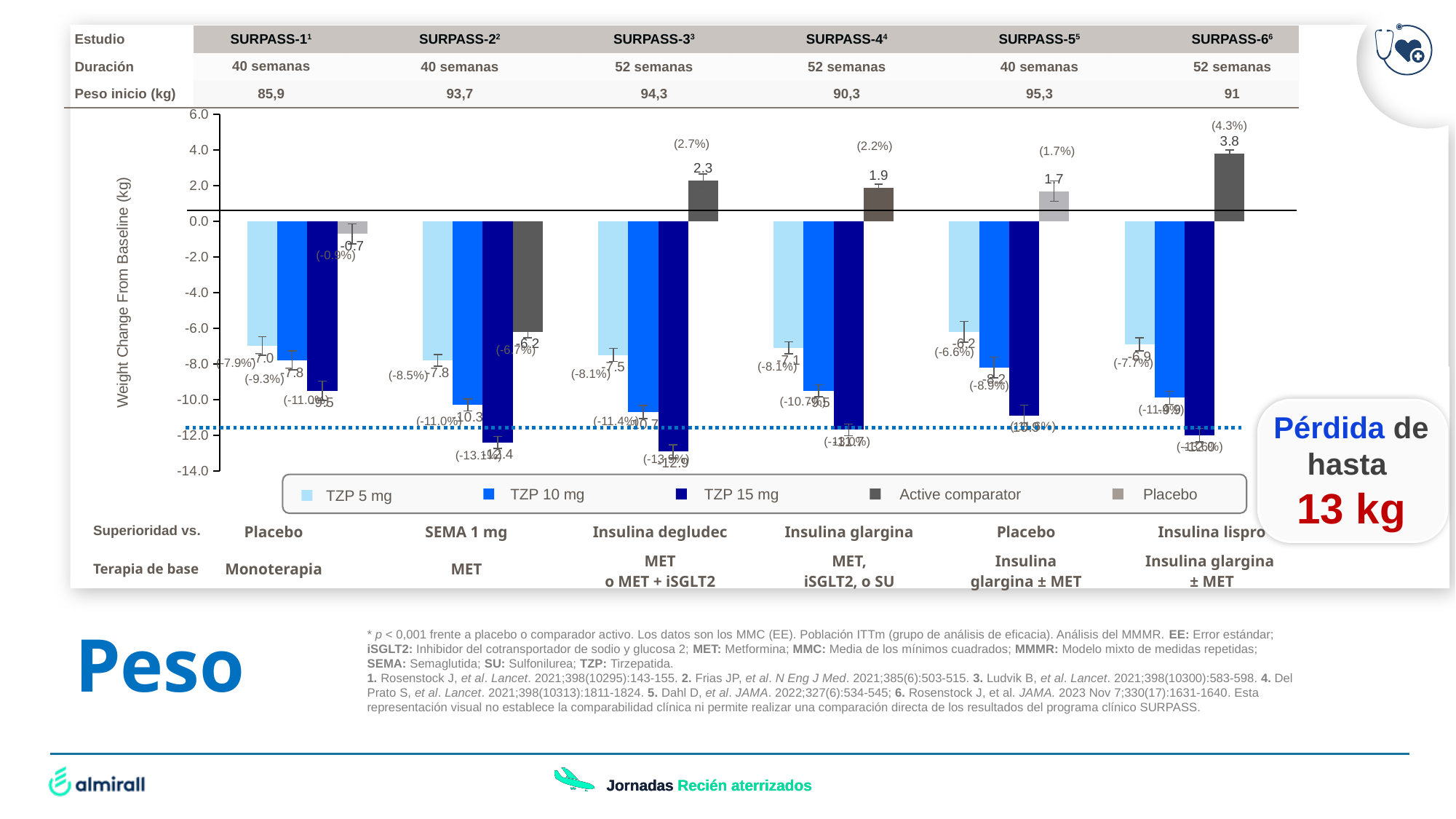
What is the difference between the active comparator values in SURPASS-3 (2.3) and SURPASS-4 (1.9)? 0.4 What is the weight change from baseline for TZP 15 mg in SURPASS-3? -12.9 What is the weight change from baseline for TZP 5 mg in SURPASS-1? -7.0 Is the TZP 5 mg value in SURPASS-5 greater or less than -4.0? less What kind of chart is shown on the slide? bar chart What is the weight change from baseline for the active comparator in SURPASS-6? 3.8 What is the weight change from baseline for placebo in SURPASS-5? 1.7 How many SURPASS studies are plotted along the x axis of the chart? 6 Which is larger: the active comparator value in SURPASS-3 or in SURPASS-6? SURPASS-6 In SURPASS-2, what is the difference between the TZP 5 mg value (-7.8) and the TZP 15 mg value (-12.4)? 4.6 How many series does the chart legend list? 5 In which study does the active comparator show the largest weight gain? SURPASS-6